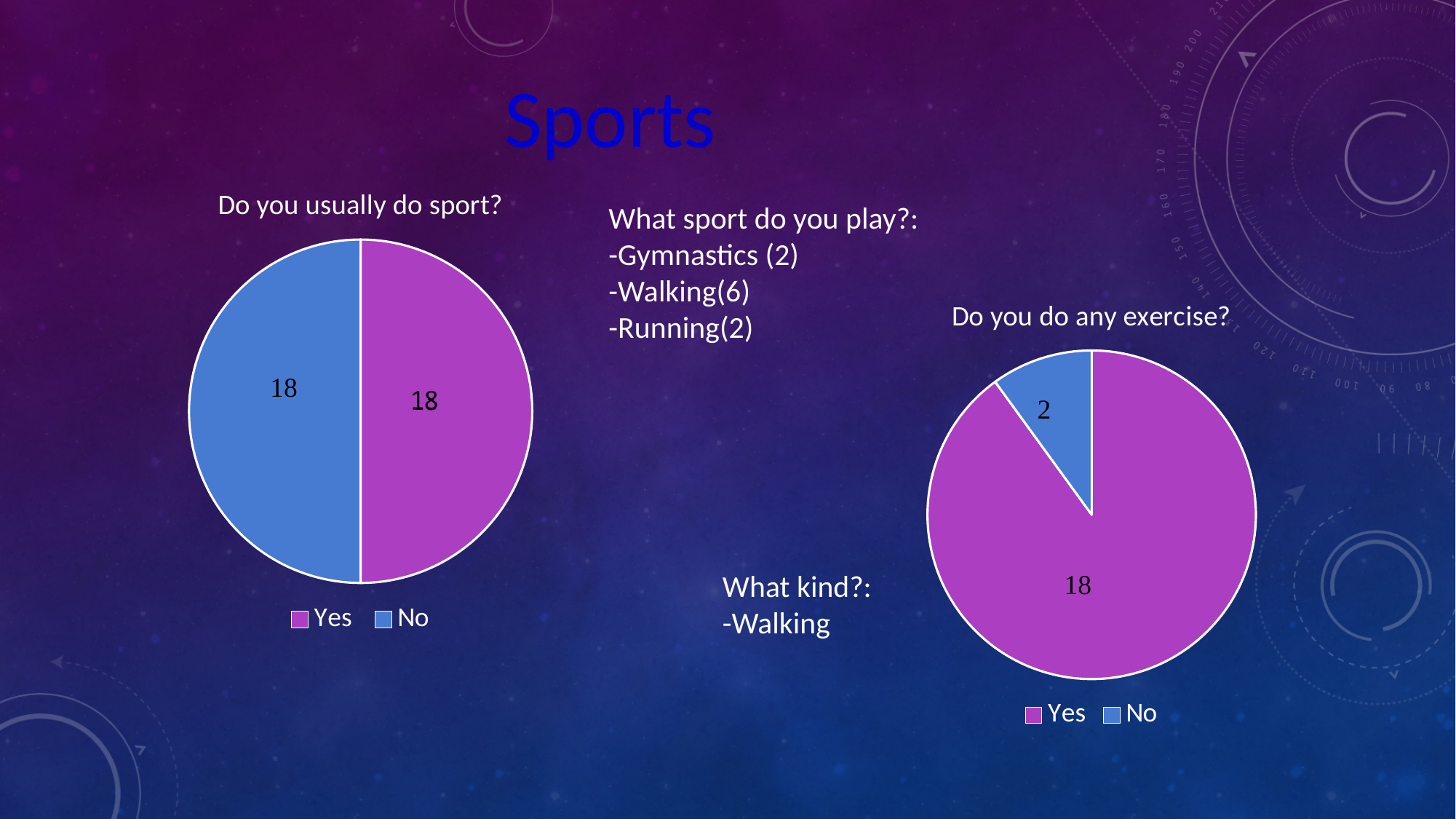
In the 'Do you usually do sport?' chart, what is the value for Yes? 18 In the 'Do you do any exercise?' chart, is the value for Yes larger or smaller than the value for No? larger What kind of chart is the 'Do you usually do sport?' chart? pie chart In the 'Do you do any exercise?' chart, what is the value for Yes? 18 In the 'Do you do any exercise?' chart, what share of the total does the Yes slice represent? 90% In the 'Do you do any exercise?' chart, which category has the largest slice? Yes In the 'Do you do any exercise?' chart, what is the difference between the Yes and No values? 16 In the 'Do you do any exercise?' chart, what is the value for No? 2 In the 'Do you usually do sport?' chart, what share of the total does the No slice represent? 50% In the 'Do you usually do sport?' chart, what is the value for No? 18 How many categories does the legend of the 'Do you do any exercise?' chart list? 2 In the 'Do you do any exercise?' chart, which category has the smallest slice? No